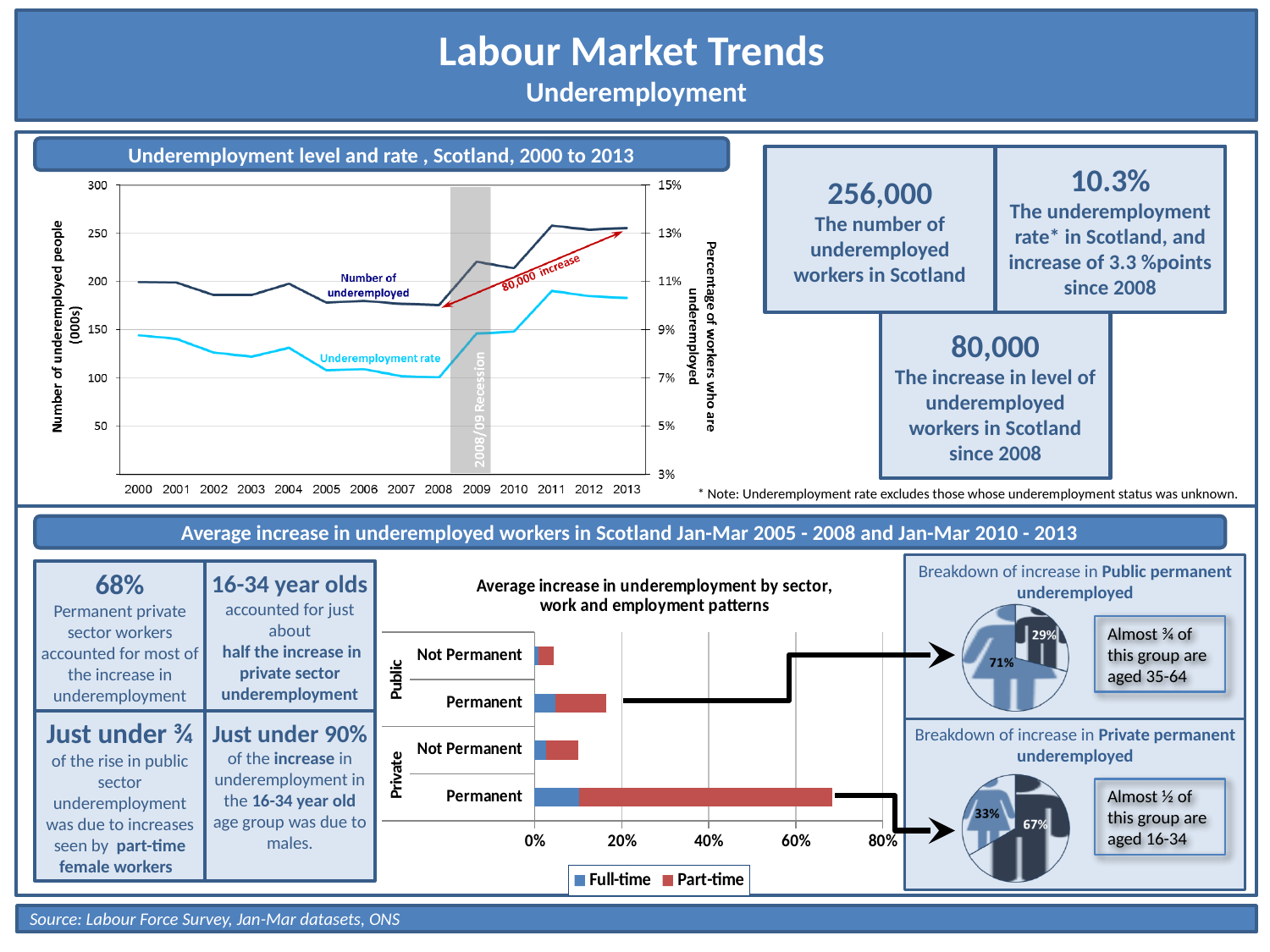
In the 'Underemployment level and rate' chart, does the number of underemployed rise or fall between 2008 and 2011? Rise In the 'Underemployment level and rate' chart, is the underemployment rate in 2011 greater or less than 9%? greater How many series does the legend of the 'Average increase in underemployment by sector, work and employment patterns' chart list? 2 In the 'Average increase in underemployment by sector, work and employment patterns' chart, is the total bar for Private Permanent greater or less than 60%? greater What kind of chart is 'Average increase in underemployment by sector, work and employment patterns'? Bar chart In the pie chart 'Breakdown of increase in Private permanent underemployed', what is the share of the smaller slice? 33% In the 'Average increase in underemployment by sector, work and employment patterns' chart, which category has the shortest bar? Public Not Permanent In the 'Average increase in underemployment by sector, work and employment patterns' chart, which category has the longest bar? Private Permanent In the pie chart 'Breakdown of increase in Public permanent underemployed', what is the share of the larger slice? 71% How many years are shown on the x axis of the 'Underemployment level and rate, Scotland, 2000 to 2013' chart? 14 What kind of chart is the 'Underemployment level and rate, Scotland, 2000 to 2013' chart? Line chart In the 'Underemployment level and rate' chart, is the number of underemployed in 2008 greater or less than 200 (000s)? less